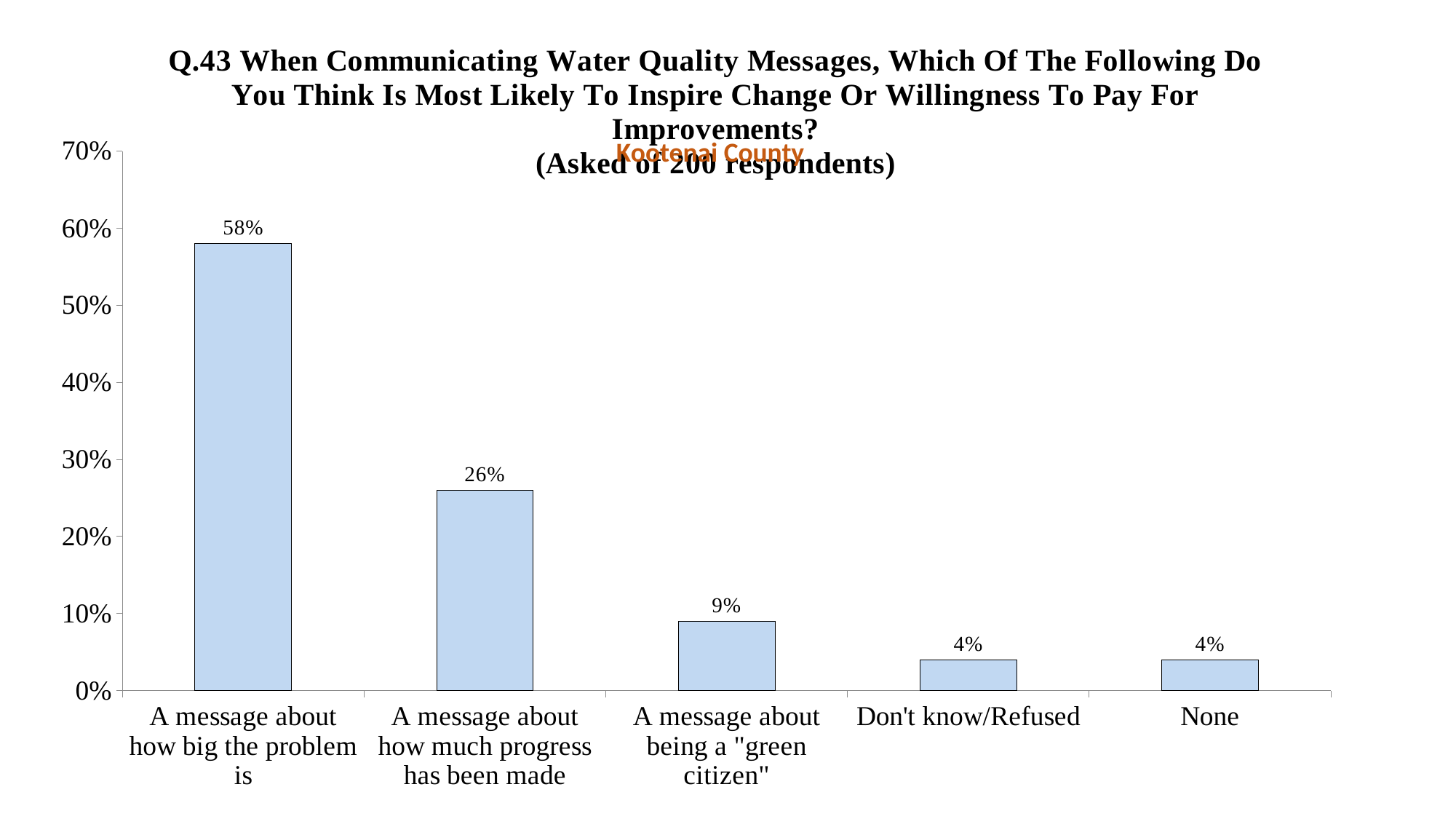
Do the values rise or fall from left to right along the x axis? fall What is the difference between "A message about how big the problem is" and "A message about how much progress has been made"? 32% How many categories are shown on the x axis? 5 Which is larger: "A message about how much progress has been made" or "A message about being a "green citizen""? A message about how much progress has been made What percentage of respondents chose "A message about how much progress has been made"? 26% What is the value for "A message about being a "green citizen""? 9% How many respondents were asked this question, according to the chart title? 200 Which category has the highest value? A message about how big the problem is What is the value for "Don't know/Refused"? 4% Is the value for "A message about how big the problem is" greater or less than 50%? greater What percentage of respondents chose "A message about how big the problem is"? 58% What kind of chart is shown on the slide? bar chart